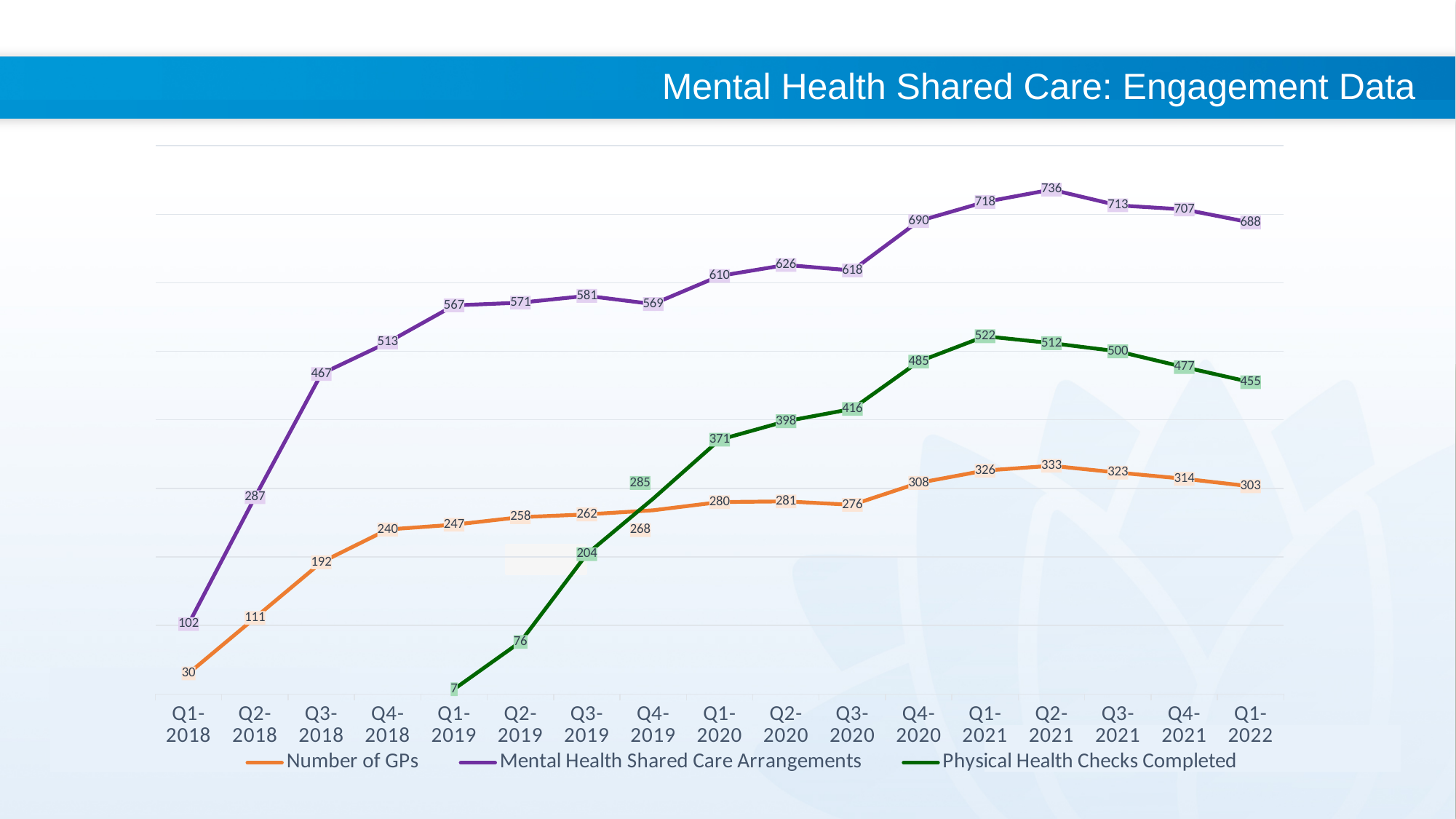
Which is larger in Q4-2019: Number of GPs or Physical Health Checks Completed? Physical Health Checks Completed What is the value of Mental Health Shared Care Arrangements in Q2-2021? 736 What colour is the line for Mental Health Shared Care Arrangements? Purple How many series does the legend list? 3 What is the difference between Mental Health Shared Care Arrangements and Physical Health Checks Completed in Q1-2022? 233 In which quarter is Mental Health Shared Care Arrangements lowest? Q1-2018 How many quarters are shown along the x axis? 17 Does the Physical Health Checks Completed series rise or fall from Q1-2021 to Q1-2022? Fall What is the value of Physical Health Checks Completed in Q1-2019? 7 What is the Number of GPs in Q4-2018? 240 What type of chart is shown on the slide? Line chart In which quarter does the Number of GPs reach its highest value? Q2-2021